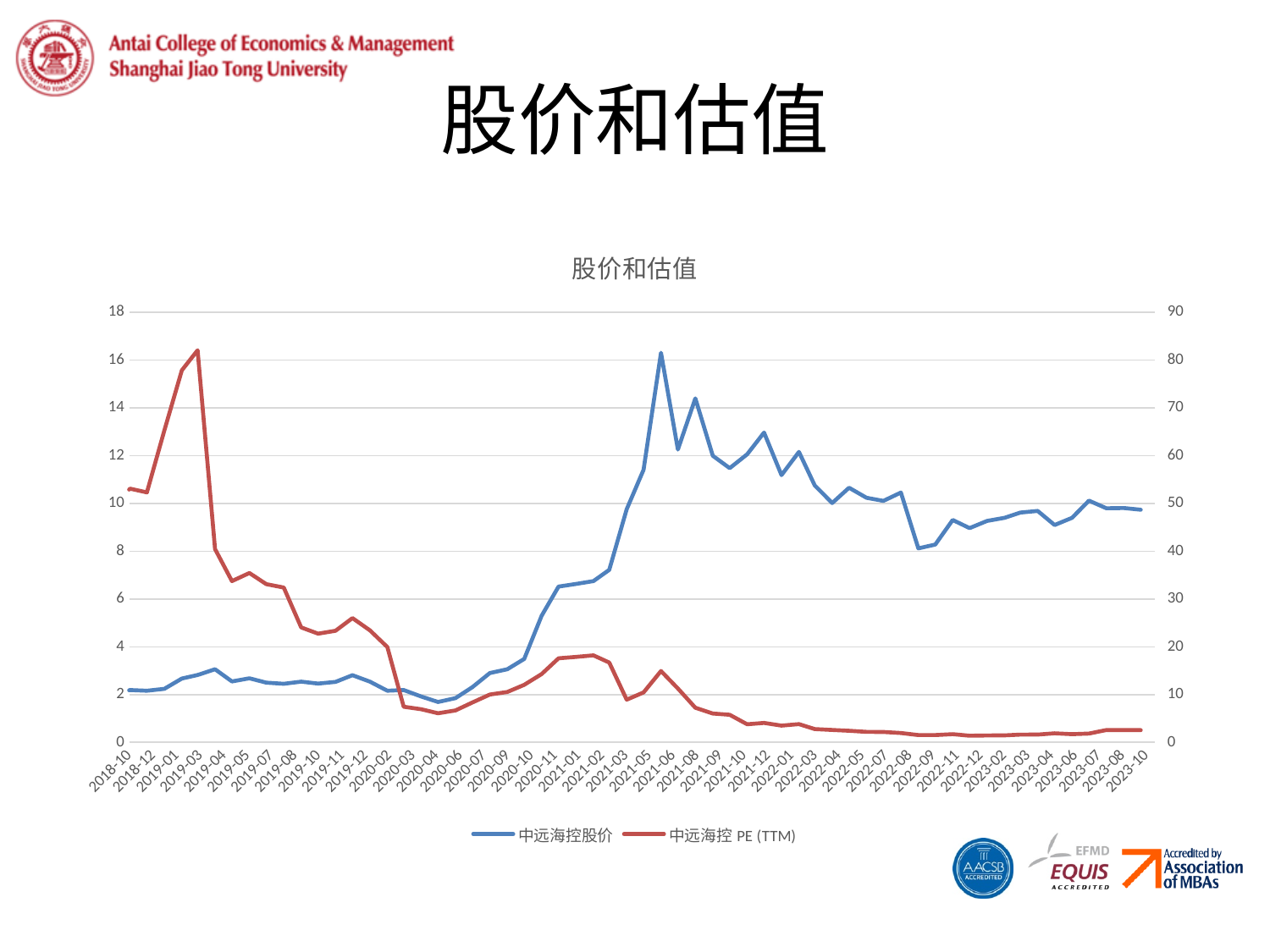
Does the 中远海控 PE (TTM) line rise or fall between 2019-03 and 2020-04? fall In which month does the 中远海控股价 line reach its highest point? 2021-06 Is the value for 中远海控 PE (TTM) in 2019-03 greater or less than 70 on the right axis? greater What kind of chart is shown on the slide? line chart Is the value for 中远海控股价 in 2018-10 greater or less than 4 on the left axis? less Does the 中远海控股价 line rise or fall between 2020-04 and 2021-06? rise How many series does the legend list? 2 Is the value for 中远海控股价 in 2021-06 greater or less than 14 on the left axis? greater In which month does the 中远海控 PE (TTM) line reach its highest point? 2019-03 Which series is drawn in red? 中远海控 PE (TTM) What is the title of the chart? 股价和估值